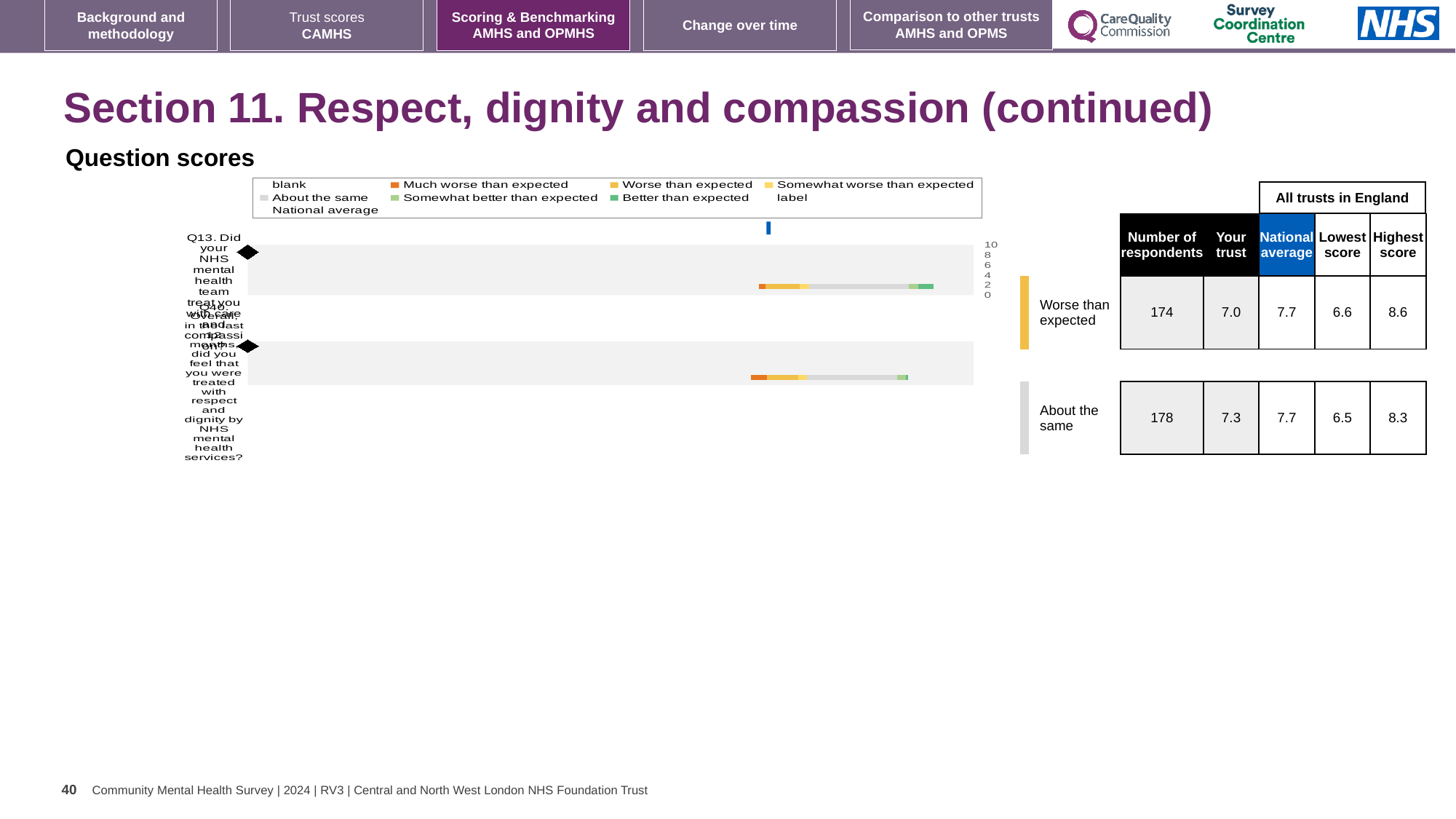
What is the national average score for Q13? 7.7 How many questions are plotted in the question scores chart? 2 What is the lowest score across all trusts in England for Q10? 6.5 What is the 'Your trust' score for Q13 (the first question in the chart)? 7.0 How many respondents are listed for Q13? 174 What kind of chart is used to show the question scores on this slide? bar chart Which question has the higher 'Your trust' score, Q13 or Q10? Q10 What is the 'Your trust' score for Q10 (the second question in the chart)? 7.3 Which benchmark category is Q13 rated as in the chart? Worse than expected What is the difference between the national average and the 'Your trust' score for Q13? 0.7 What is the highest score across all trusts in England for Q13? 8.6 How many respondents are listed for Q10? 178